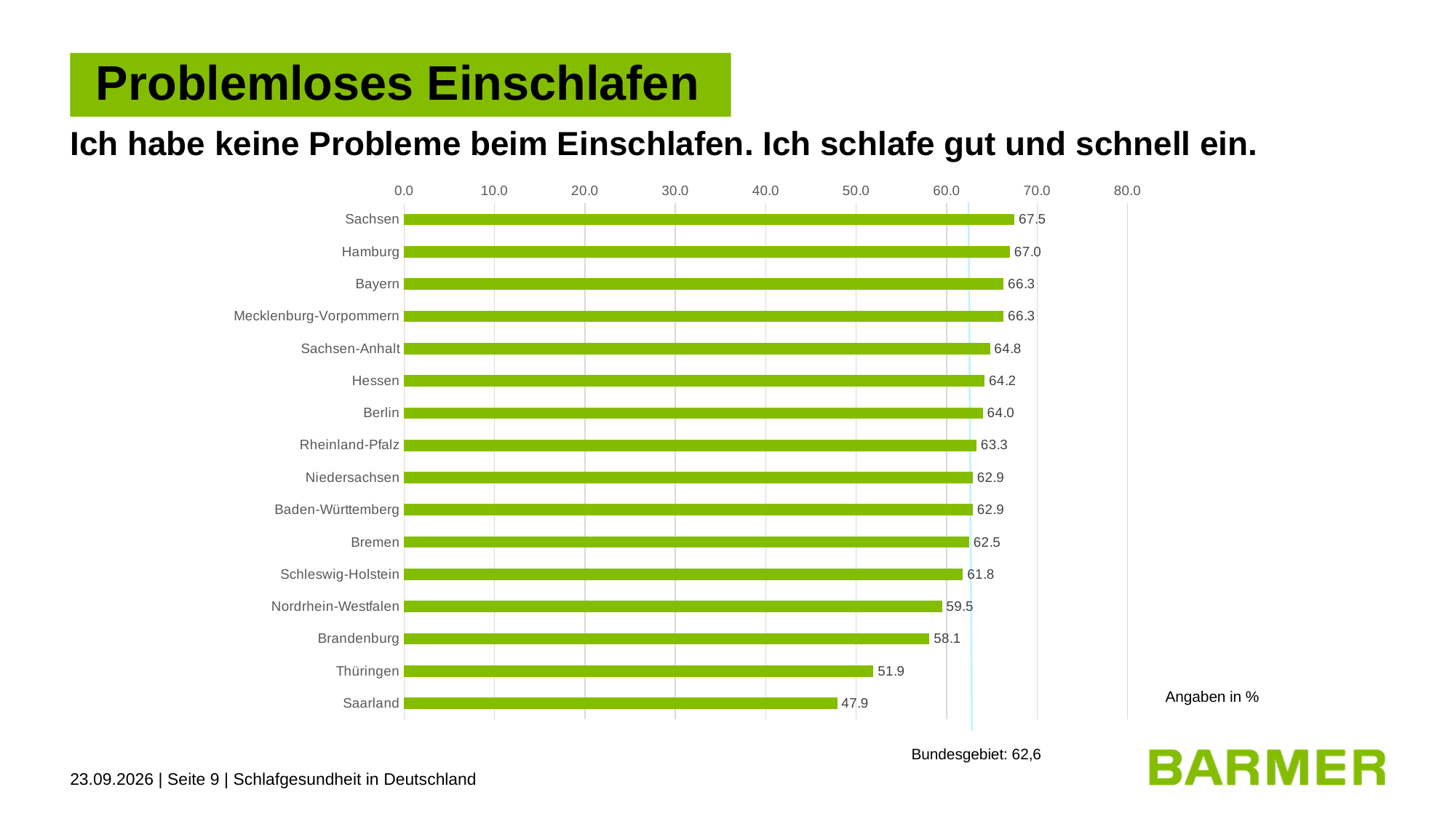
Which federal state has the lowest value? Saarland What is the difference between the values for Hamburg and Thüringen? 15.1 Which federal state has the highest value? Sachsen What is the value for Saarland? 47.9 What kind of chart is shown on the slide? Bar chart Is the value for Thüringen greater or less than 50.0? greater Which has a larger value, Brandenburg or Bremen? Bremen What is the value for Nordrhein-Westfalen? 59.5 How many federal states are shown in the chart? 16 What is the value for Sachsen? 67.5 What value is given for Bundesgebiet below the chart? 62,6 What is the difference between the values for Sachsen and Saarland? 19.6